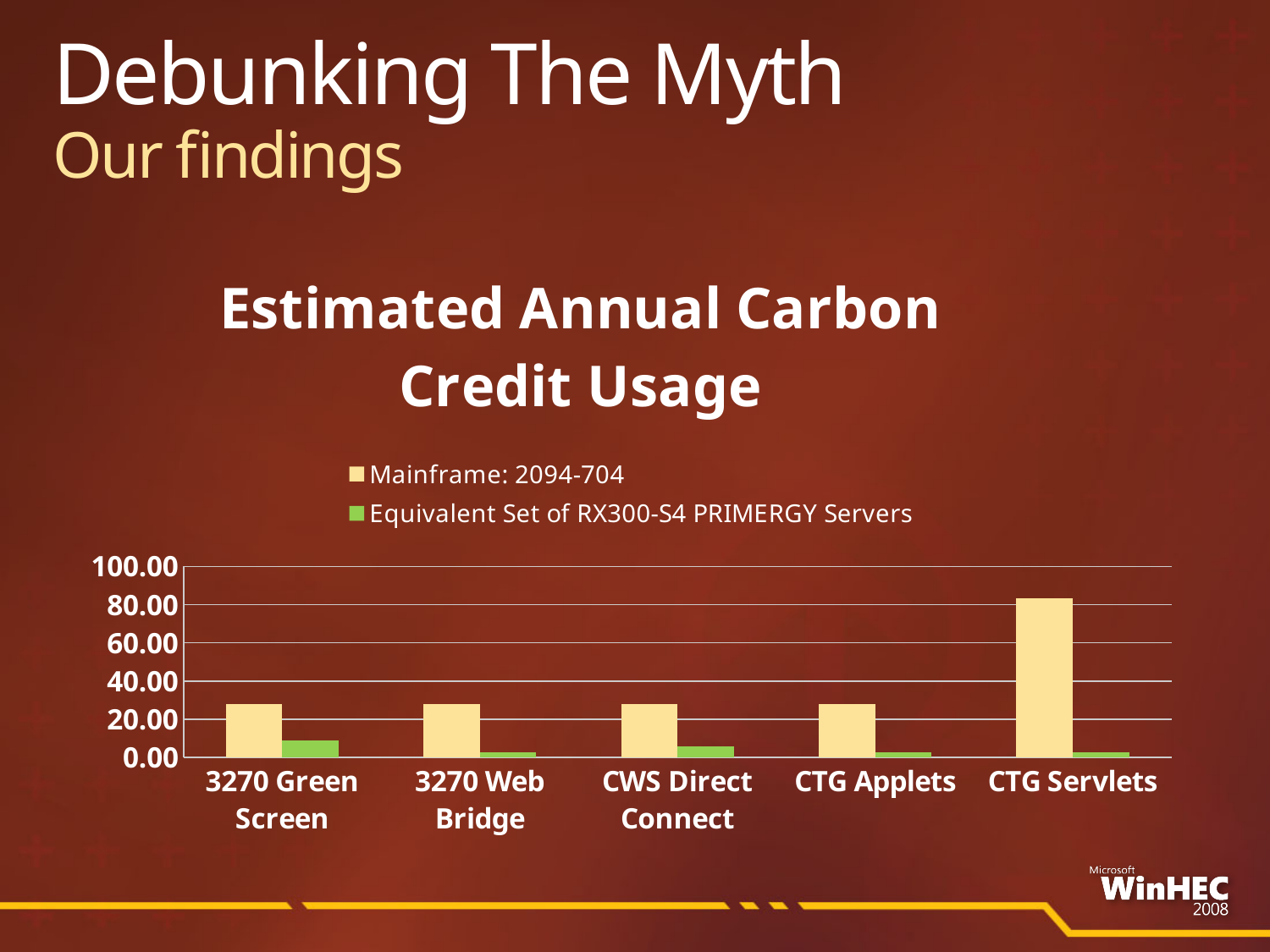
What is the title of the chart? Estimated Annual Carbon Credit Usage Which colour represents the Equivalent Set of RX300-S4 PRIMERGY Servers series? green Is the Mainframe: 2094-704 value for 3270 Green Screen greater or less than 40.00? less For CTG Servlets, which series has the larger value: Mainframe: 2094-704 or Equivalent Set of RX300-S4 PRIMERGY Servers? Mainframe: 2094-704 How many categories are shown on the x axis? 5 Is the Mainframe: 2094-704 value for CWS Direct Connect greater or less than 20.00? greater Is the Equivalent Set of RX300-S4 PRIMERGY Servers value for CTG Applets greater or less than 20.00? less What kind of chart is shown on the slide? bar chart How many series does the legend list? 2 For 3270 Web Bridge, which series has the larger value: Mainframe: 2094-704 or Equivalent Set of RX300-S4 PRIMERGY Servers? Mainframe: 2094-704 Which category has the highest value for the Mainframe: 2094-704 series? CTG Servlets